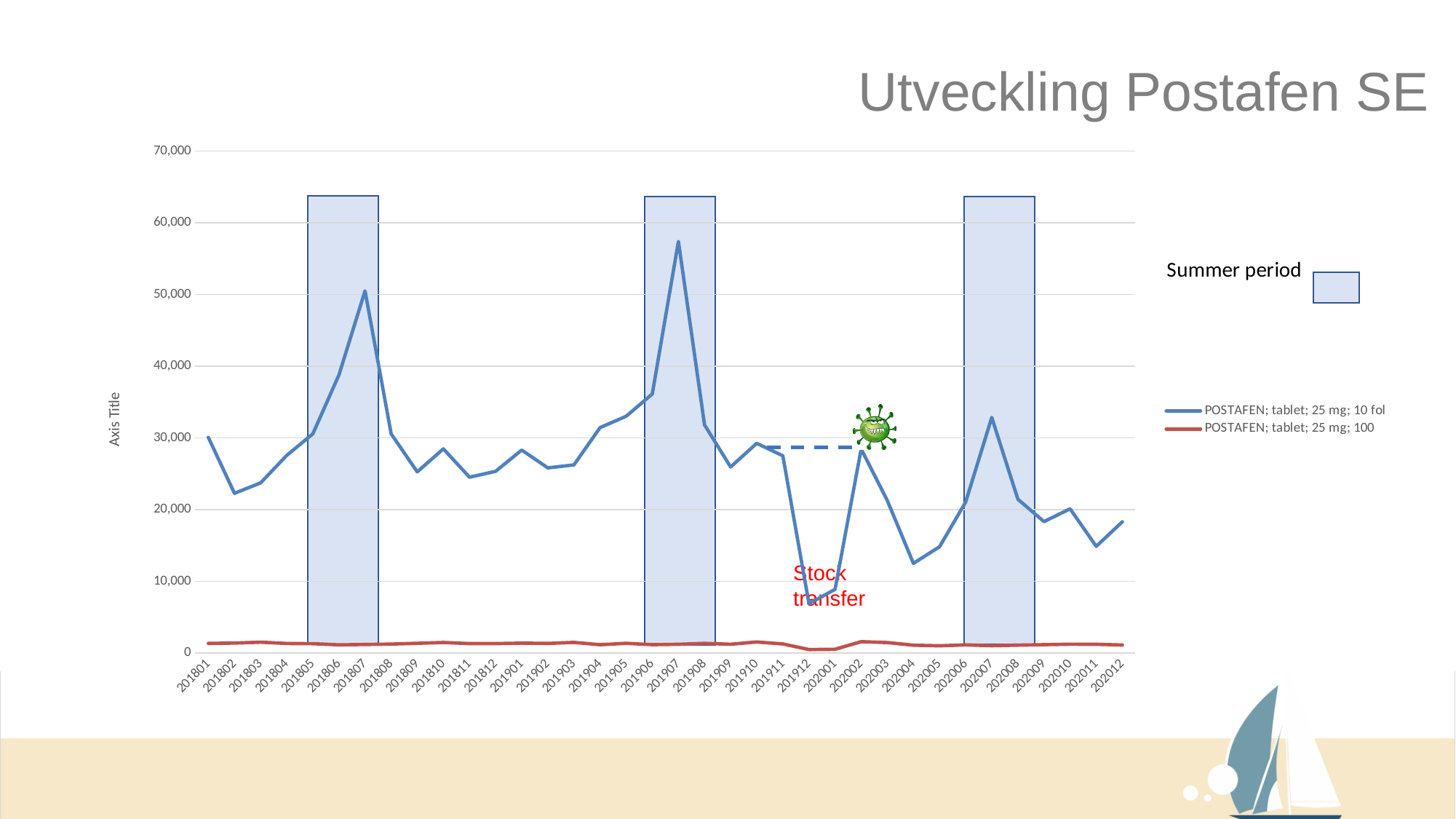
At which month does the 'POSTAFEN; tablet; 25 mg; 10 fol' series reach its highest value? 201907 Is the value for 'POSTAFEN; tablet; 25 mg; 100' at 201907 greater or less than 10,000? less What do the shaded blue rectangles on the chart represent, according to the legend? Summer period How many points (months) are plotted along the x axis? 36 At which month does the 'POSTAFEN; tablet; 25 mg; 10 fol' series reach its lowest value? 201912 Is the value for 'POSTAFEN; tablet; 25 mg; 10 fol' at 201912 greater or less than 10,000? less Which is larger for the 'POSTAFEN; tablet; 25 mg; 10 fol' series: the value at 201807 or at 201907? 201907 What is the title of the slide? Utveckling Postafen SE How many series does the legend list? 2 What kind of chart is shown on the slide? line chart Does the 'POSTAFEN; tablet; 25 mg; 10 fol' series rise or fall between 201907 and 201912? fall Is the value for 'POSTAFEN; tablet; 25 mg; 10 fol' at 201907 greater or less than 50,000? greater